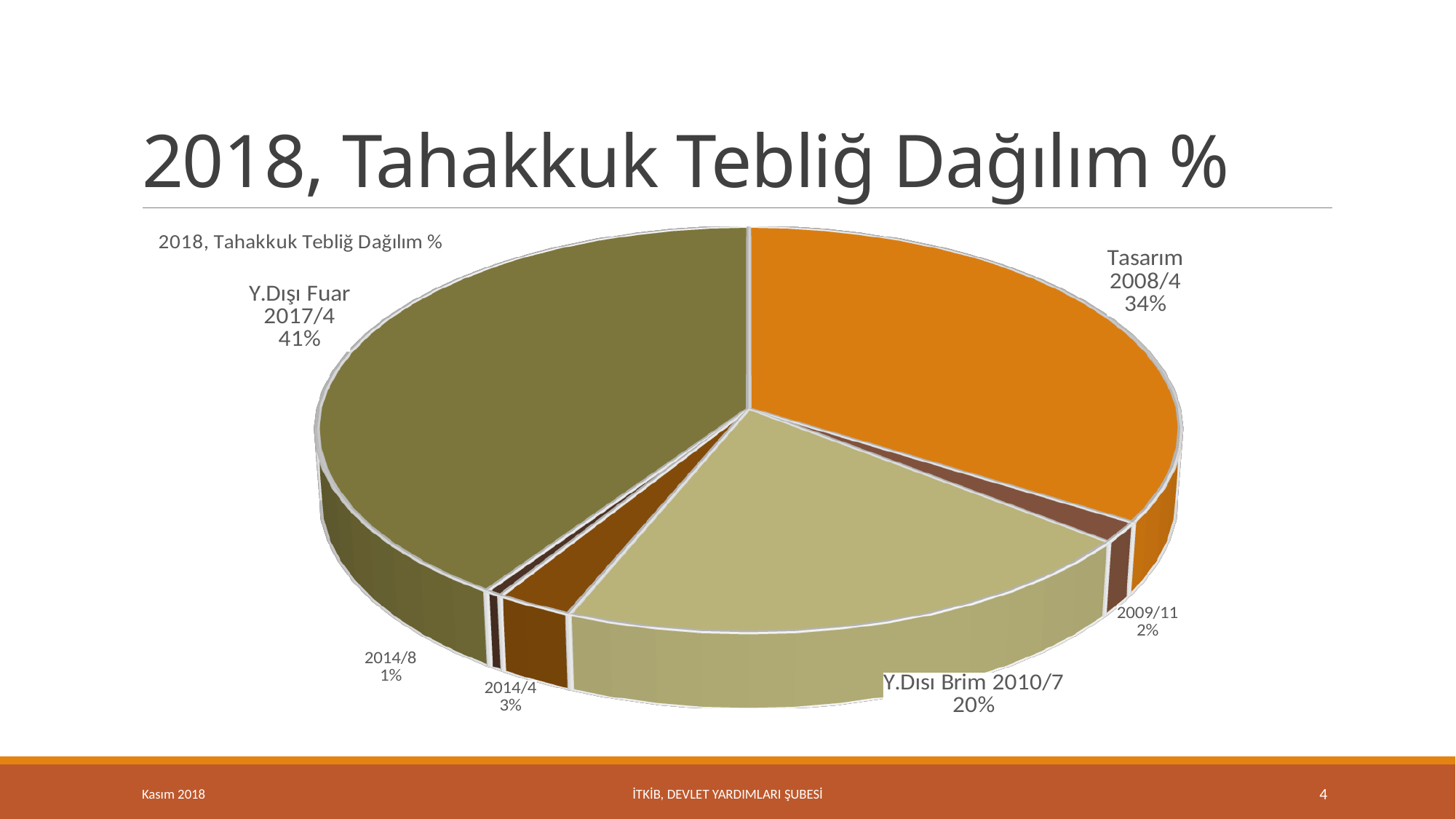
What percentage is shown for 2014/4? 3% What share of the pie does Y.Dısı Brim 2010/7 have? 20% What is the difference in percentage points between Y.Dışı Fuar 2017/4 and Tasarım 2008/4? 7 What share of the pie does Tasarım 2008/4 have? 34% Which slice has the largest share of the pie? Y.Dışı Fuar 2017/4 What percentage is shown for 2009/11? 2% What kind of chart is shown on the slide? pie chart How many slices does the pie chart have? 6 What is the title of the chart? 2018, Tahakkuk Tebliğ Dağılım % What share of the pie does Y.Dışı Fuar 2017/4 have? 41% Which is larger, the share for Y.Dısı Brim 2010/7 or the share for 2014/4? Y.Dısı Brim 2010/7 Which slice has the smallest share of the pie? 2014/8